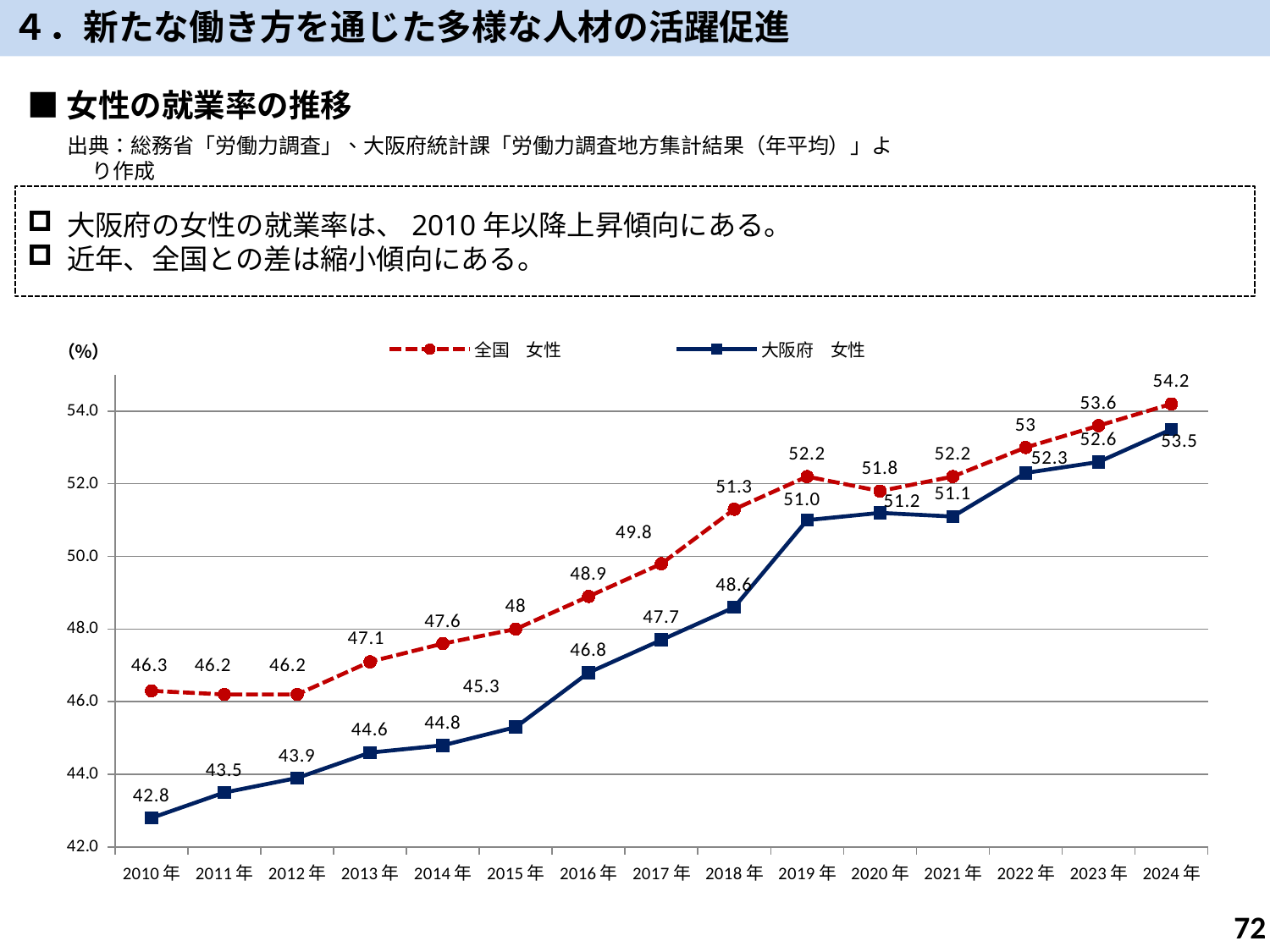
2019年の大阪府 女性の値はいくつですか？ 51.0 このグラフの種類は何ですか？ 折れ線グラフ 2024年の大阪府 女性の就業率は何%ですか？ 53.5 大阪府 女性の就業率が最も低いのは何年ですか？ 2010年 2020年の全国 女性と大阪府 女性では、どちらの値が大きいですか？ 全国 女性 凡例にはいくつの系列が示されていますか？ 2 2018年の大阪府 女性の値は48.0より大きいですか、小さいですか？ 大きい 2024年の全国 女性と大阪府 女性の差は何ポイントですか？ 0.7 このグラフには何年分のデータ（横軸の項目数）がありますか？ 15 2010年の全国 女性と大阪府 女性の差は何ポイントですか？ 3.5 全国 女性の就業率が最も高いのは何年ですか？ 2024年 2010年の全国 女性の就業率は何%ですか？ 46.3